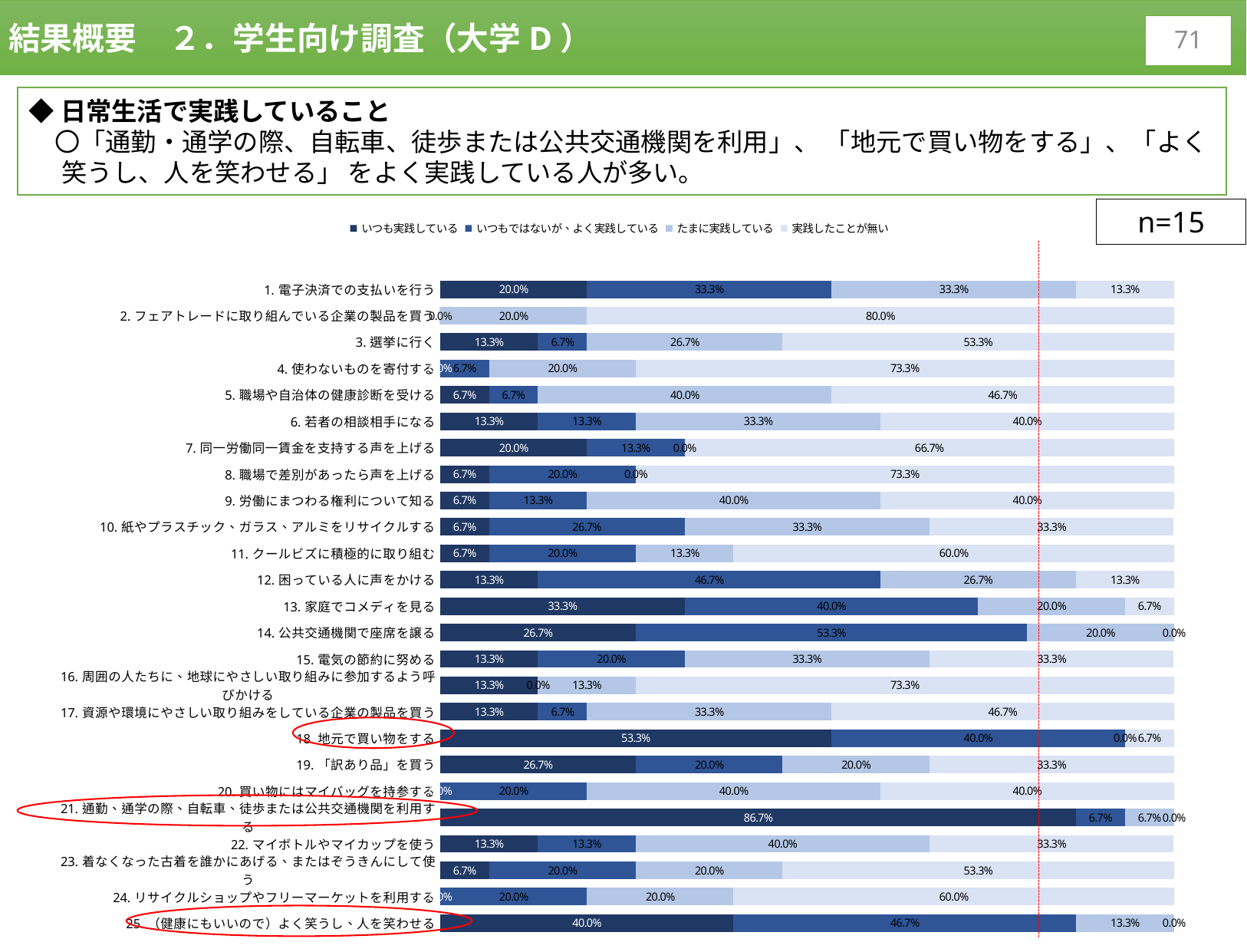
What sample size (n) is shown on the slide? n=15 What is the difference between the 「いつも実践している」 values for item 21 (通勤・通学) and item 18 (地元で買い物をする)? 33.4% Which item has the highest value for 「実践したことが無い」? 2. フェアトレードに取り組んでいる企業の製品を買う What is the value of 「実践したことが無い」 for item 3 (選挙に行く)? 53.3% What is the value of 「いつもではないが、よく実践している」 for item 25 (よく笑うし、人を笑わせる)? 46.7% What is the value of 「いつも実践している」 for item 18 (地元で買い物をする)? 53.3% What kind of chart is shown on the slide? bar chart What is the value of 「いつも実践している」 for item 21 (通勤、通学の際、自転車、徒歩または公共交通機関を利用する)? 86.7% Which item has the highest value for 「いつも実践している」? 21. 通勤、通学の際、自転車、徒歩または公共交通機関を利用する How many categories (items) are plotted in the chart? 25 How many series does the legend list? 4 Which is larger: the 「いつも実践している」 value for item 13 (家庭でコメディを見る) or for item 14 (公共交通機関で座席を譲る)? 13. 家庭でコメディを見る